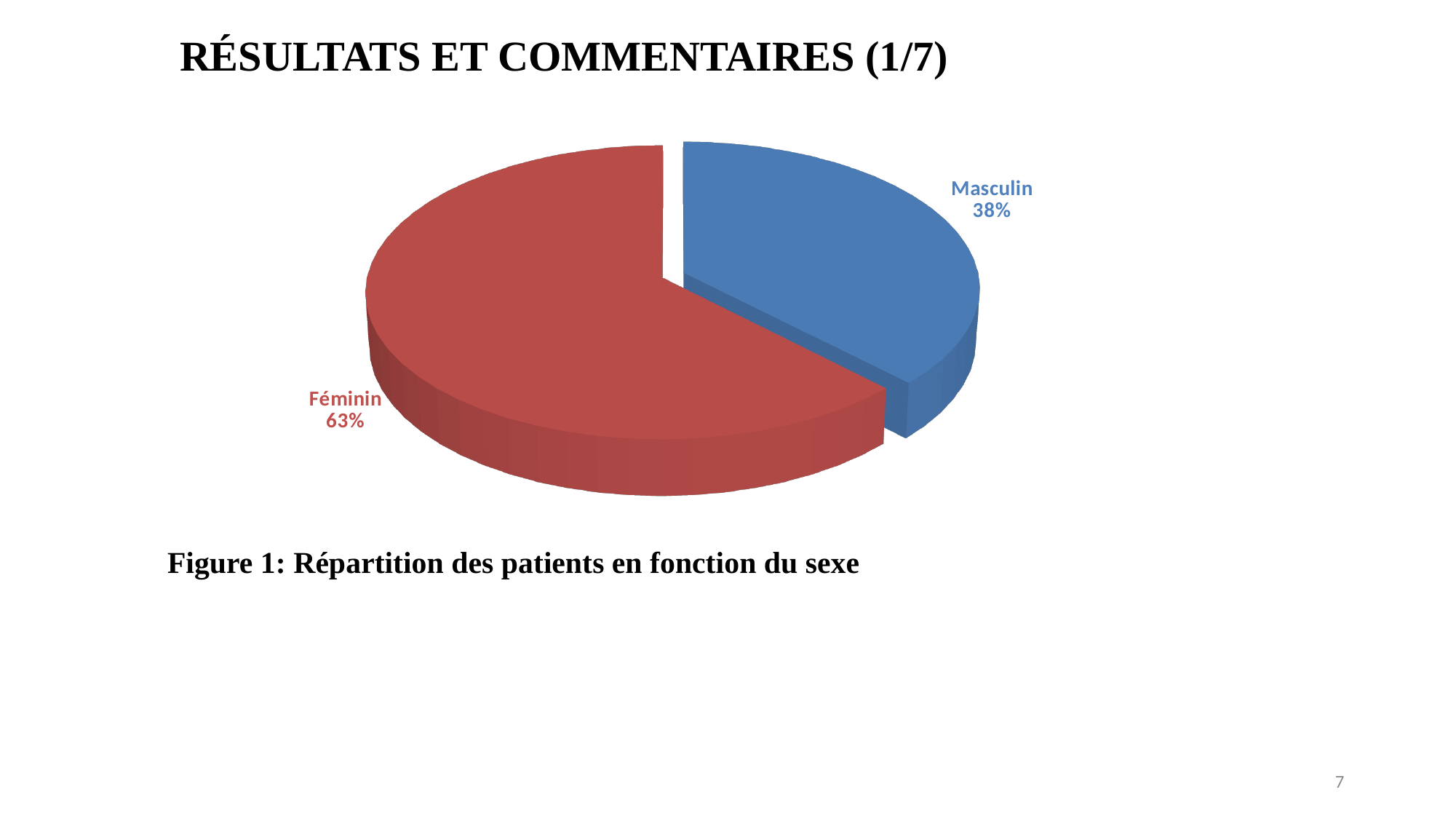
What kind of chart is shown on the slide? Pie chart Which category has the smallest share of the pie? Masculin What share of patients is Masculin? 38% What colour is the Masculin slice? Blue What is the difference in percentage points between the Féminin and Masculin shares? 25 Which category has the largest share of the pie? Féminin How many categories does the pie chart show? 2 Which is larger, the Féminin share or the Masculin share? Féminin What is the caption of the figure on the slide? Figure 1: Répartition des patients en fonction du sexe What share of patients is Féminin? 63%